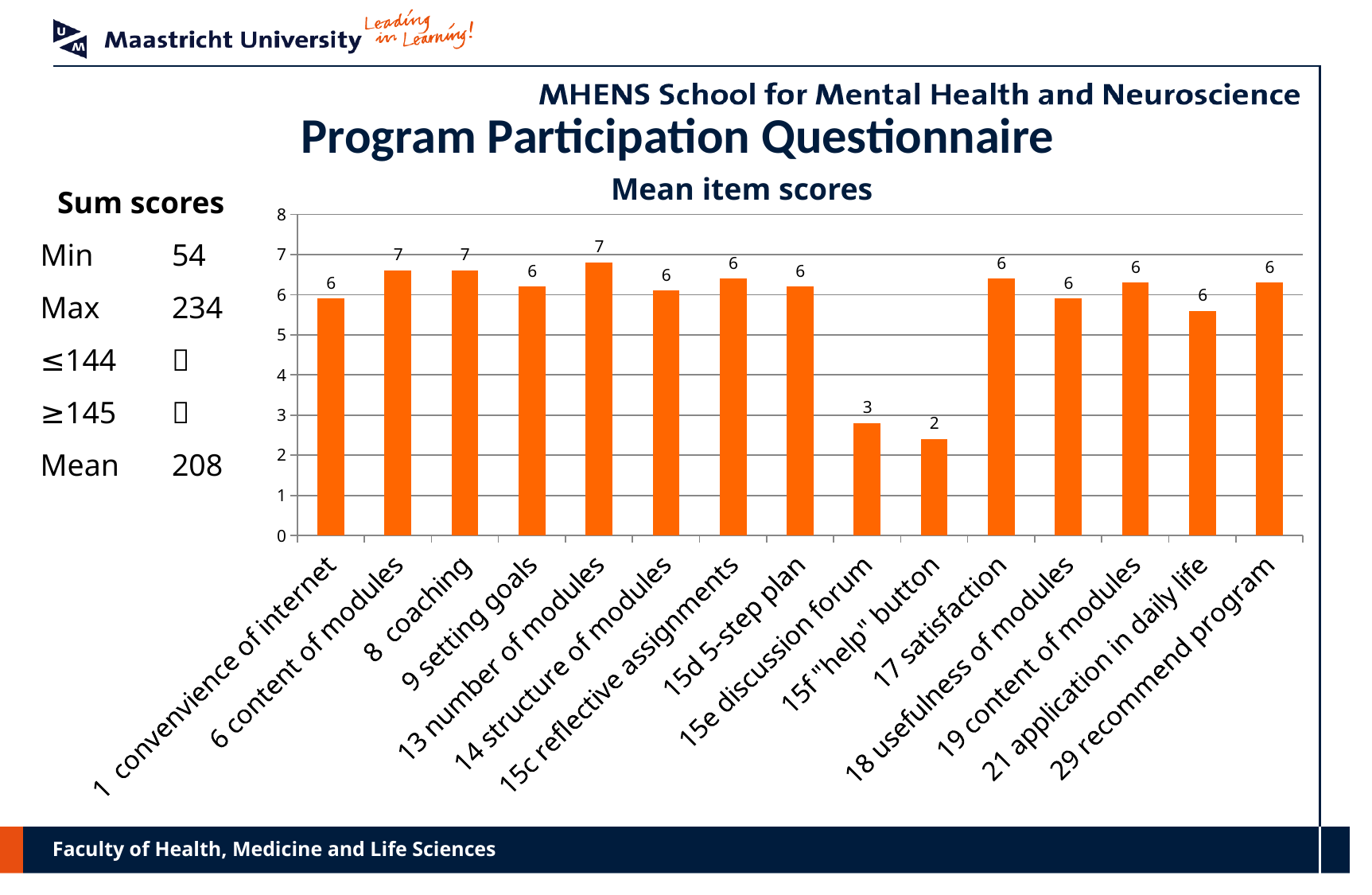
Which has the higher mean item score: '15e discussion forum' or '15f "help" button'? 15e discussion forum What kind of chart is shown on the slide? bar chart What is the mean item score shown for '15f "help" button'? 2 What is the title of the chart? Mean item scores What is the mean item score shown for '13 number of modules'? 7 Which item has the lowest mean item score? 15f "help" button What is the difference between the labelled scores for '15e discussion forum' and '15f "help" button'? 1 What is the mean item score shown for '15e discussion forum'? 3 What is the mean item score shown for '17 satisfaction'? 6 How many items (categories) are plotted in the chart? 15 What colour are the bars in the chart? orange